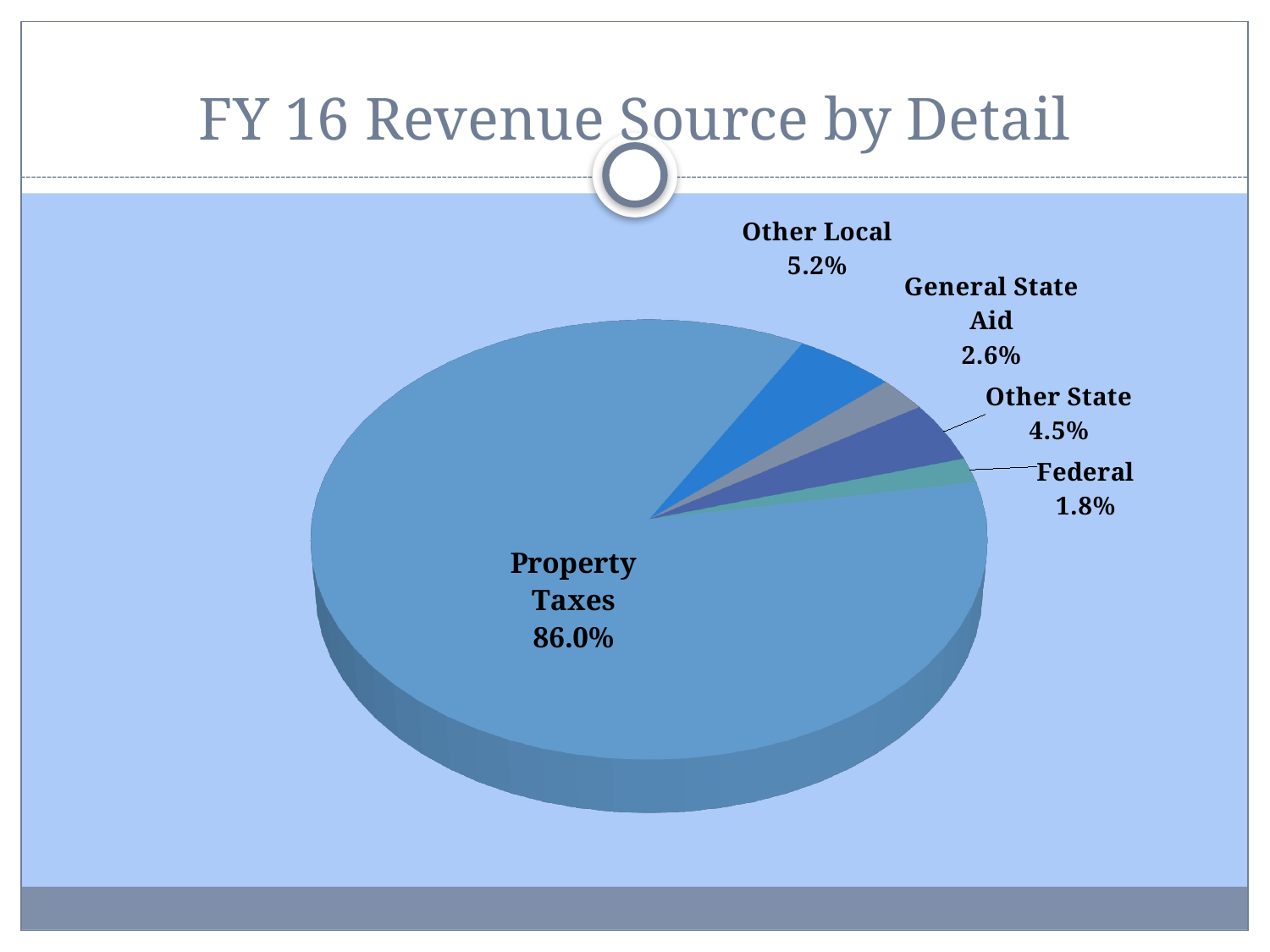
What is the title of the chart? FY 16 Revenue Source by Detail Which is larger, the share for Other Local or the share for Other State? Other Local What share of revenue comes from Federal? 1.8% How many revenue sources are shown in the pie chart? 5 Which revenue source has the largest share? Property Taxes What share of revenue comes from Other State? 4.5% What share of revenue comes from General State Aid? 2.6% What is the difference between the Other State share and the General State Aid share? 1.9% What share of revenue comes from Property Taxes? 86.0% What kind of chart is shown on the slide? Pie chart What share of revenue comes from Other Local? 5.2% Which revenue source has the smallest share? Federal